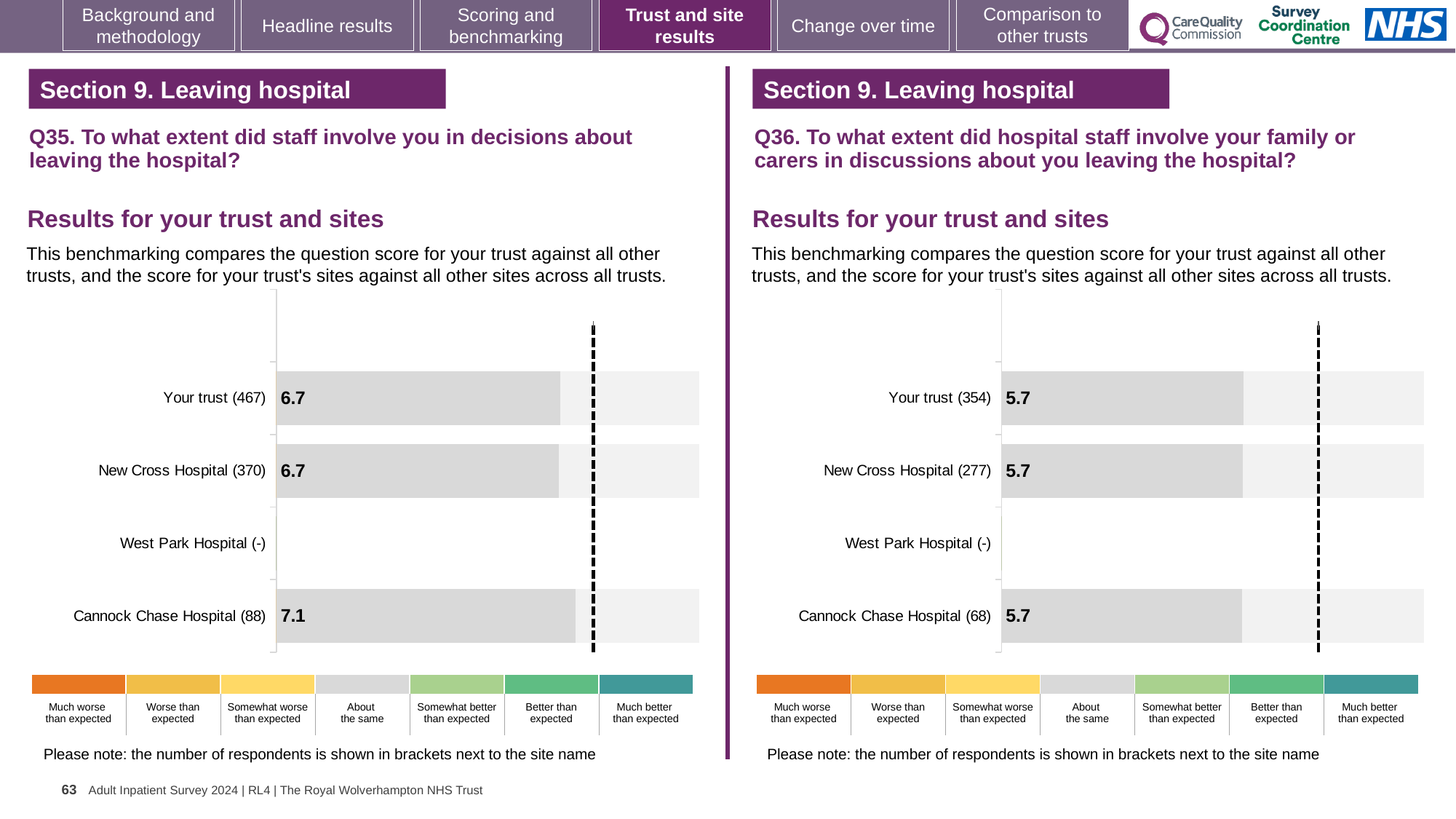
On the Q35 chart (left), what is the score for Your trust? 6.7 On the Q36 chart (right), what is the score for New Cross Hospital? 5.7 On the Q36 chart (right), what is the difference between the scores for Your trust and Cannock Chase Hospital? 0 On the Q35 chart (left), what is the difference between the scores for Cannock Chase Hospital and New Cross Hospital? 0.4 On the Q36 chart (right), what is the score for Cannock Chase Hospital? 5.7 On the Q36 chart (right), how many respondents are shown in brackets for Cannock Chase Hospital? 68 On the Q35 chart (left), which site or trust has the highest score? Cannock Chase Hospital What kind of chart is used on the Q36 chart (right)? Bar chart On the Q36 chart (right), how many sites or trusts are listed on the vertical axis? 4 On the Q35 chart (left), which has the larger score, Cannock Chase Hospital or Your trust? Cannock Chase Hospital On the Q35 chart (left), how many respondents are shown in brackets for Your trust? 467 On the Q35 chart (left), what is the score for Cannock Chase Hospital? 7.1